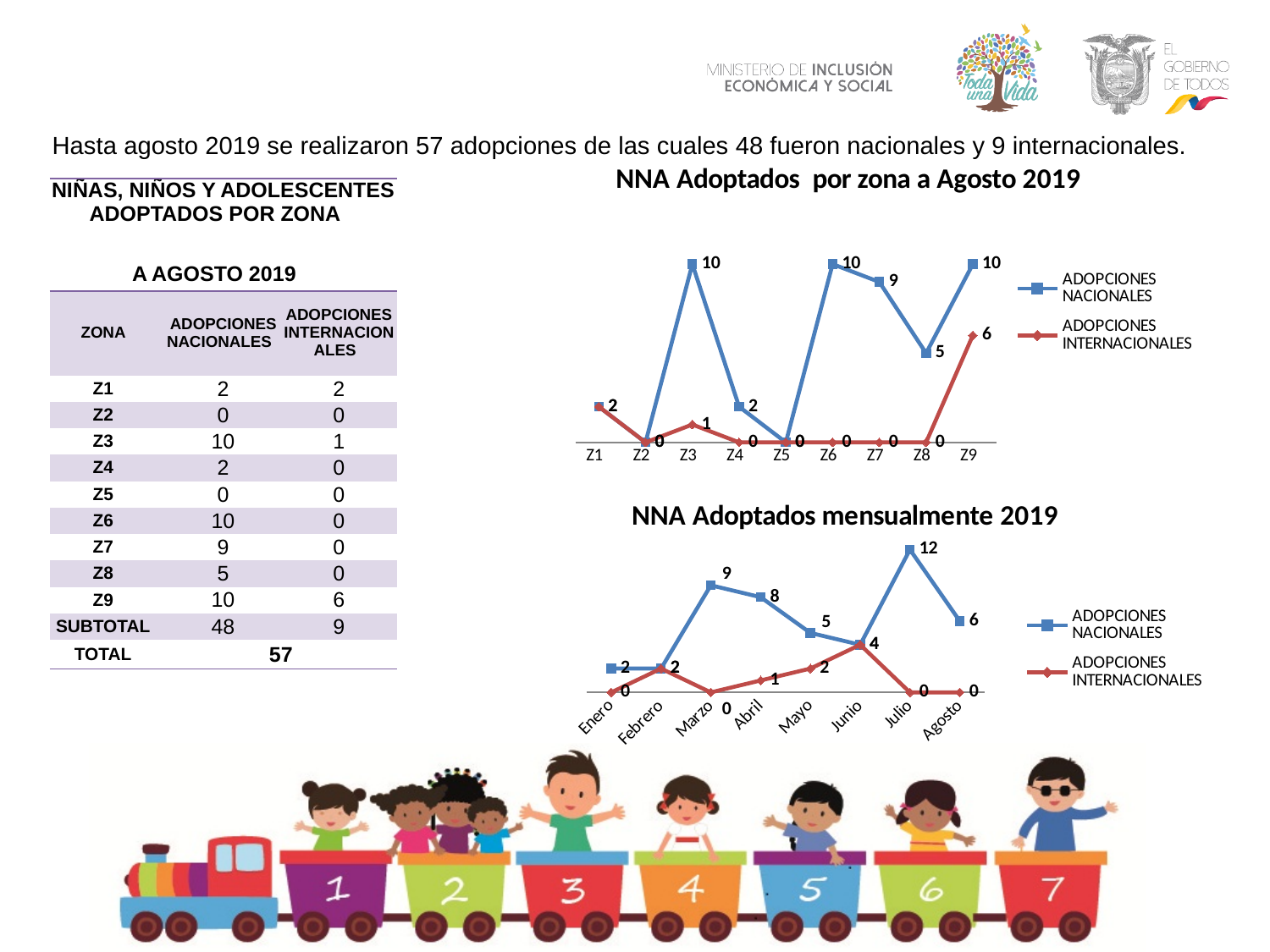
In the chart 'NNA Adoptados mensualmente 2019', how many months are shown on the x axis? 8 In the chart 'NNA Adoptados por zona a Agosto 2019', what is the value of ADOPCIONES INTERNACIONALES for Z9? 6 In the chart 'NNA Adoptados mensualmente 2019', what is the difference between ADOPCIONES NACIONALES for Julio and for Agosto? 6 In the chart 'NNA Adoptados por zona a Agosto 2019', what is the value of ADOPCIONES NACIONALES for Z7? 9 In the chart 'NNA Adoptados por zona a Agosto 2019', how many zones are shown on the x axis? 9 In the chart 'NNA Adoptados mensualmente 2019', which month has the highest value for ADOPCIONES NACIONALES? Julio In the chart 'NNA Adoptados mensualmente 2019', what is the value of ADOPCIONES NACIONALES for Julio? 12 In the chart 'NNA Adoptados por zona a Agosto 2019', what is the difference between ADOPCIONES NACIONALES and ADOPCIONES INTERNACIONALES for Z3? 9 What kind of chart is 'NNA Adoptados mensualmente 2019'? Line chart In the chart 'NNA Adoptados por zona a Agosto 2019', how many series does the legend list? 2 In the chart 'NNA Adoptados mensualmente 2019', which is larger for Mayo: ADOPCIONES NACIONALES or ADOPCIONES INTERNACIONALES? ADOPCIONES NACIONALES In the chart 'NNA Adoptados por zona a Agosto 2019', which zone has the highest value for ADOPCIONES INTERNACIONALES? Z9